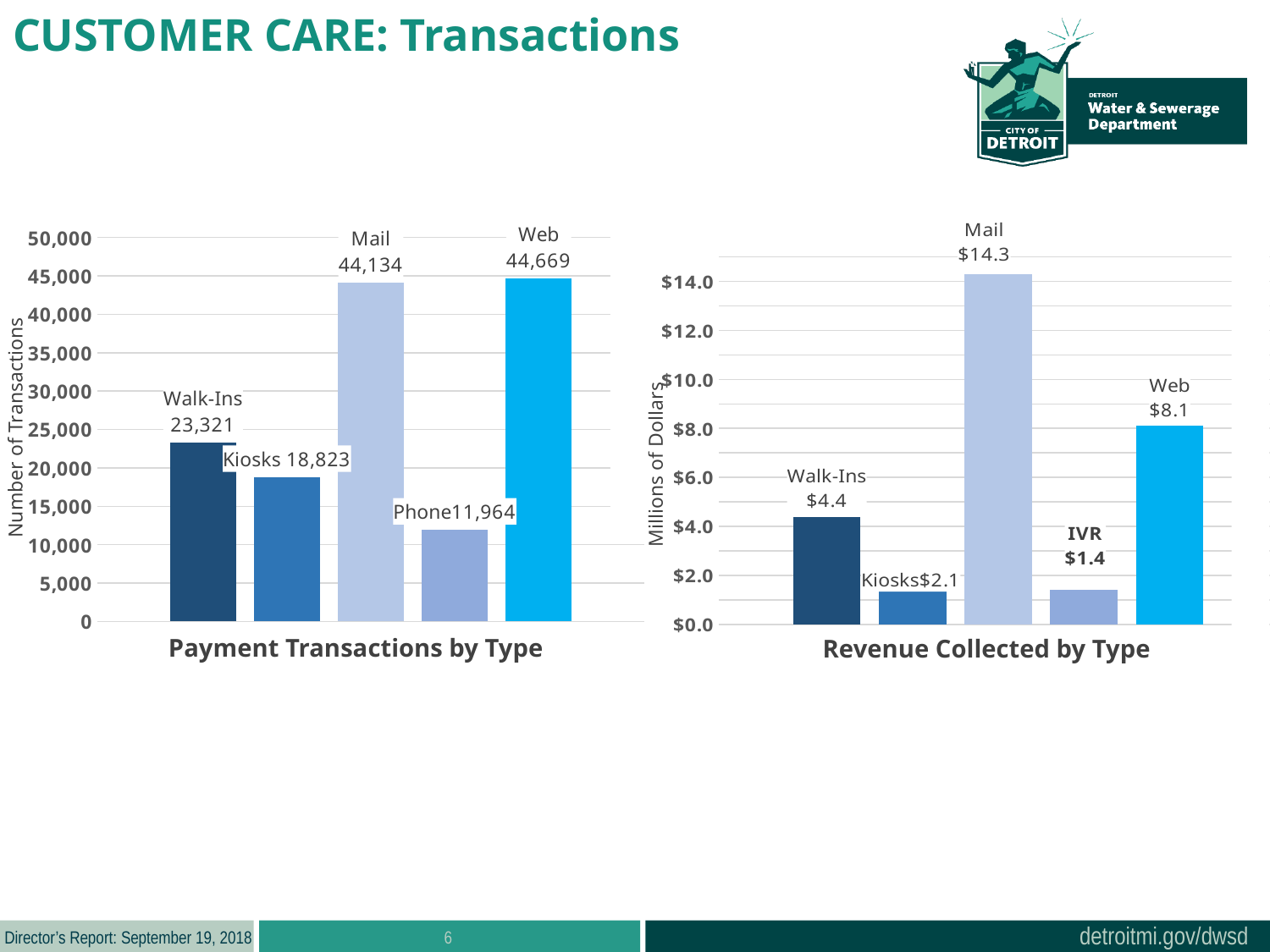
In the Payment Transactions by Type chart, which payment type has the most transactions? Web What type of chart is the Revenue Collected by Type chart? bar chart In the Payment Transactions by Type chart, what is the difference between the Mail and Walk-Ins transaction counts? 20,813 In the Payment Transactions by Type chart, how many transactions were made by Phone? 11,964 In the Payment Transactions by Type chart, which payment type has the fewest transactions? Phone In the Payment Transactions by Type chart, how many transactions were made by Mail? 44,134 In the Payment Transactions by Type chart, how many payment types are shown? 5 In the Revenue Collected by Type chart, what is the difference between the Mail and Web revenue? $6.2 In the Revenue Collected by Type chart, is the revenue for Walk-Ins greater or less than Kiosks? greater In the Revenue Collected by Type chart, which type collected the least revenue? IVR In the Revenue Collected by Type chart, how much revenue was collected by Mail? $14.3 In the Revenue Collected by Type chart, how much revenue was collected through IVR? $1.4